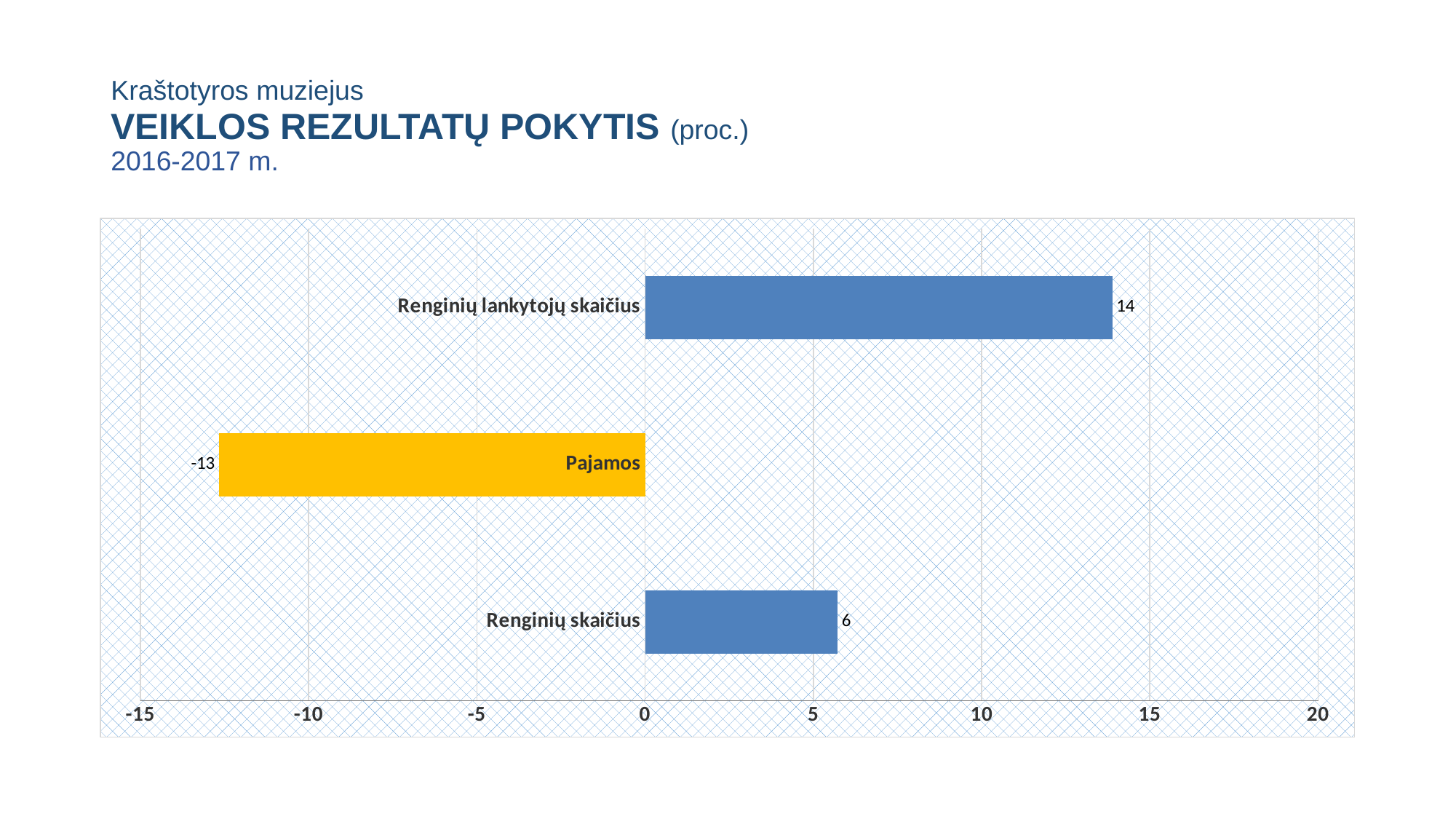
What is the value for Renginių skaičius? 6 What is the value for Renginių lankytojų skaičius? 14 Is the value for Renginių lankytojų skaičius greater or less than 10? greater Which category has the highest value? Renginių lankytojų skaičius Which is larger, the value for Renginių lankytojų skaičius or the value for Renginių skaičius? Renginių lankytojų skaičius How many categories are shown in the chart? 3 Which category has the lowest value? Pajamos What kind of chart is shown on the slide? bar chart Which category's bar is coloured yellow? Pajamos What is the value for Pajamos? -13 What is the difference between the values for Renginių lankytojų skaičius and Renginių skaičius? 8 What is the difference between the values for Renginių skaičius and Pajamos? 19